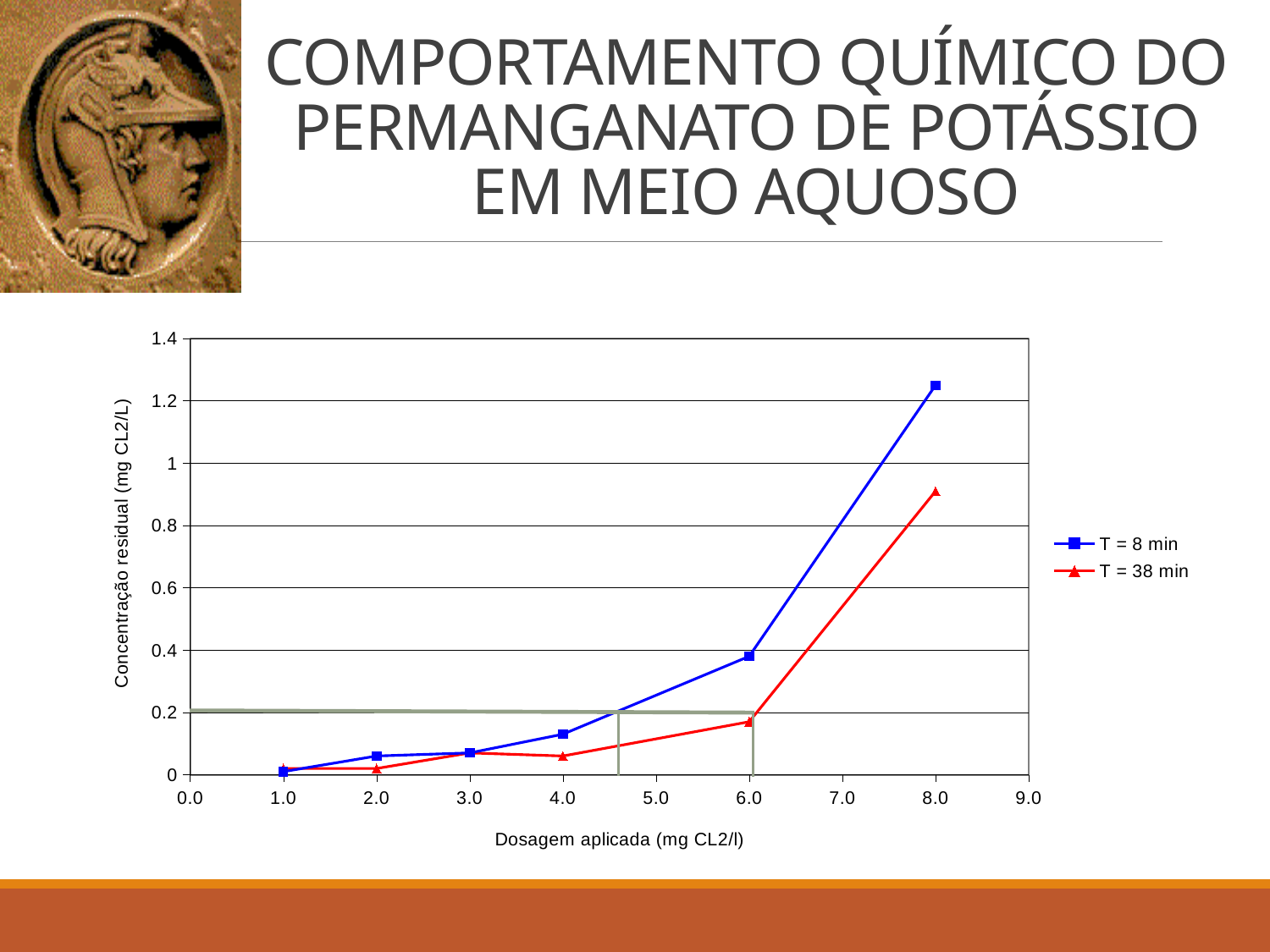
How many series does the legend list? 2 Is the residual concentration for T = 38 min at a dosage of 8.0 greater or less than 1? less At a dosage of 6.0, which series has the higher residual concentration, T = 8 min or T = 38 min? T = 8 min Is the residual concentration for T = 8 min at a dosage of 8.0 greater or less than 1? greater At a dosage of 8.0, which series has the higher residual concentration, T = 8 min or T = 38 min? T = 8 min Is the residual concentration for T = 38 min at a dosage of 6.0 greater or less than 0.4? less Does the residual concentration for T = 8 min generally rise or fall as the applied dosage increases? rise What is the title of the y axis of the chart? Concentração residual (mg CL2/L) At which applied dosage does the T = 8 min series reach its highest residual concentration? 8.0 How many data points are plotted for the T = 8 min series? 6 What kind of chart is shown on the slide? line chart